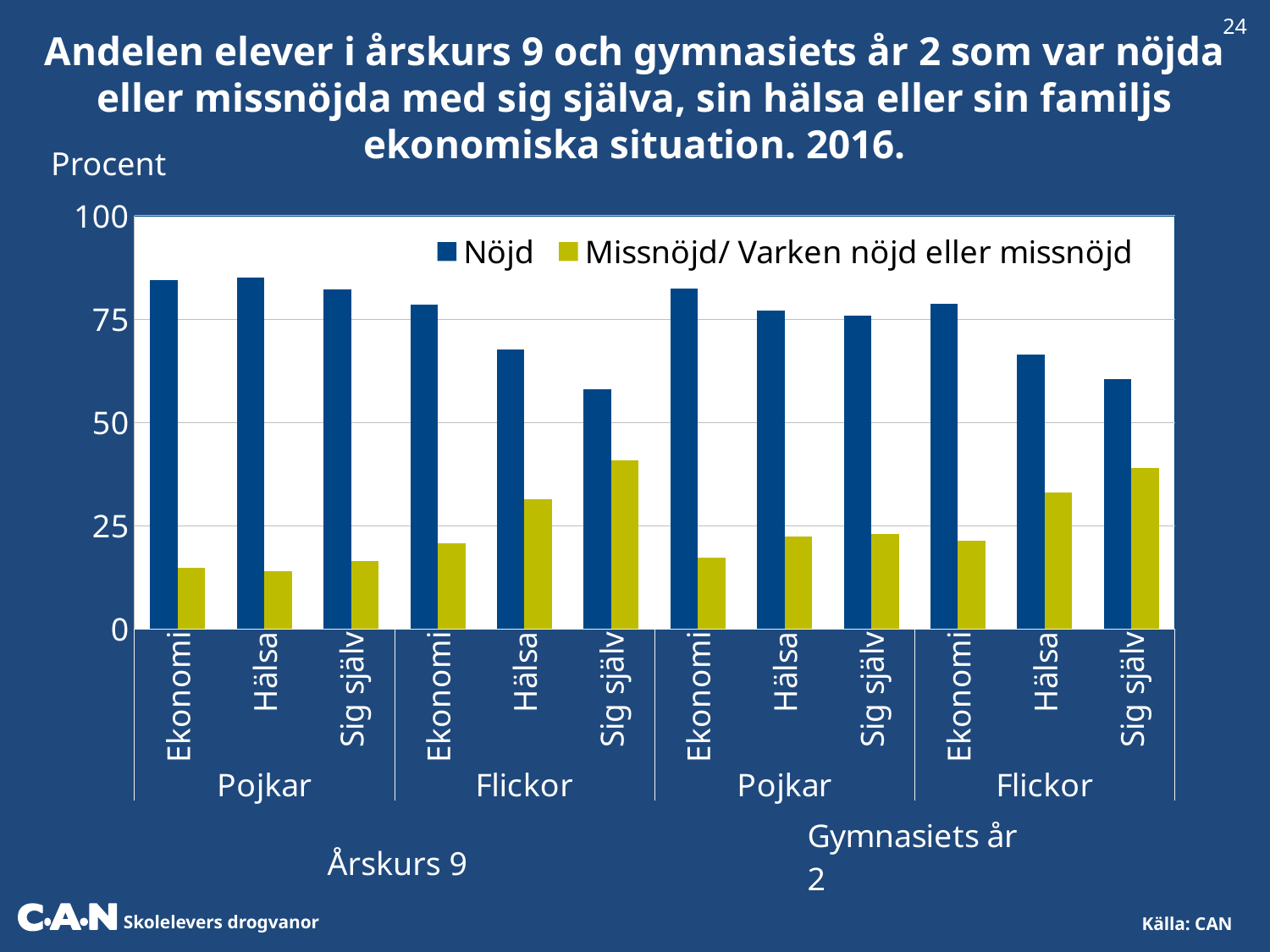
What label is shown on the vertical axis of the chart? Procent What kind of chart is shown on the slide? bar chart In Årskurs 9, is the Nöjd value for Hälsa higher for Pojkar or for Flickor? Pojkar Is the Missnöjd/ Varken nöjd eller missnöjd value for Hälsa among Flickor in Årskurs 9 greater or less than 25? greater Among Flickor in Årskurs 9, do the Nöjd values rise or fall from Ekonomi to Sig själv? fall How many pairs of bars (categories) are plotted along the x axis? 12 How many series does the legend list? 2 Is the Missnöjd/ Varken nöjd eller missnöjd value for Sig själv among Flickor in Årskurs 9 greater or less than 50? less Is the Nöjd value for Ekonomi among Pojkar in Årskurs 9 greater or less than 75? greater Among Flickor in Gymnasiets år 2, which category has the highest Missnöjd/ Varken nöjd eller missnöjd value? Sig själv Among Flickor in Årskurs 9, which category has the lowest Nöjd value? Sig själv